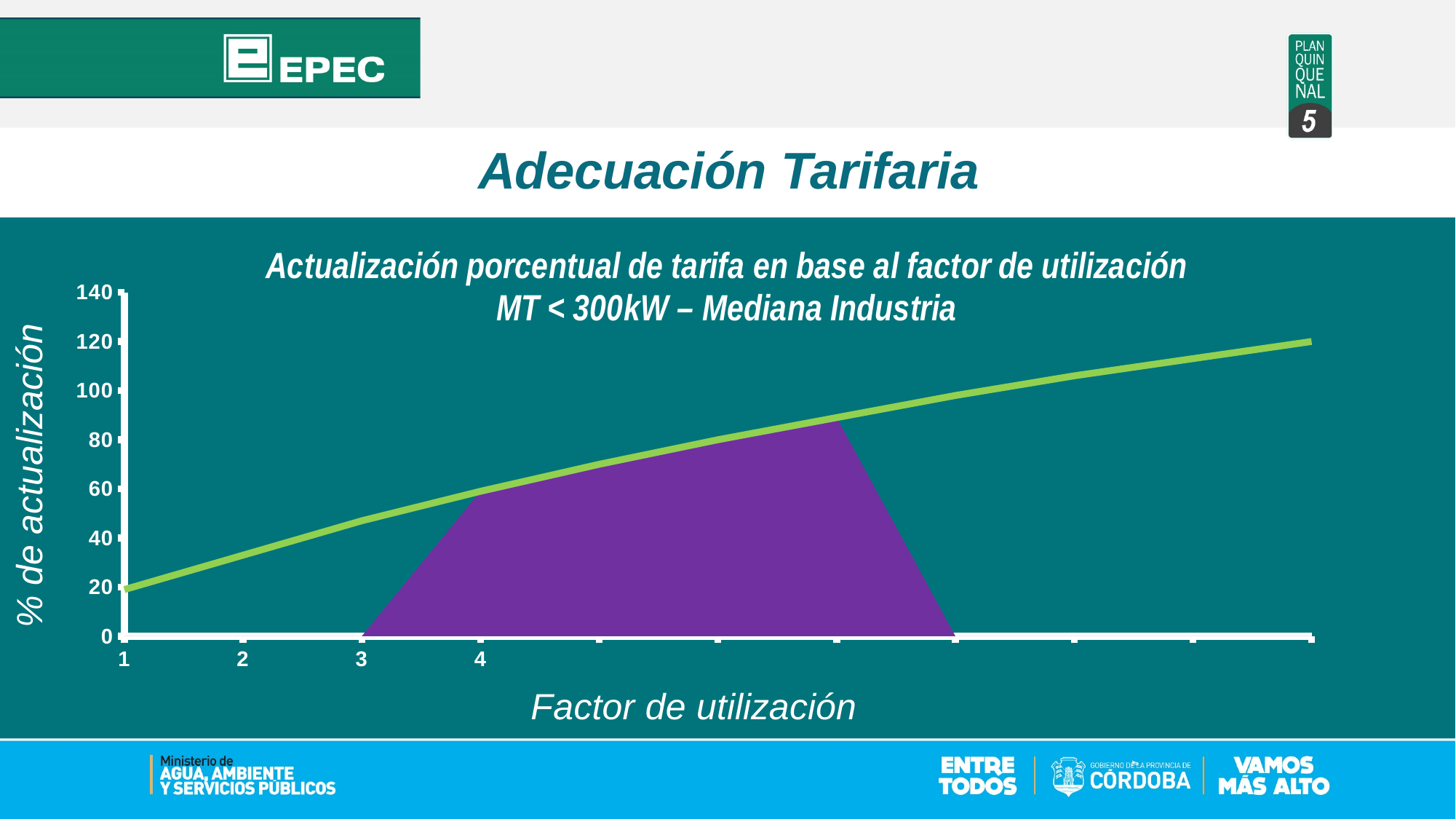
Is the value for factor de utilización 3 greater or less than 60? less Is the value for factor de utilización 4 greater or less than 40? greater Is the value for factor de utilización 1 greater or less than 40? less What is the label of the x axis of the chart? Factor de utilización What is the highest tick value shown on the y axis? 140 Which has the larger value, factor de utilización 2 or factor de utilización 4? 4 What kind of chart is shown on the slide? line chart Do the values of the line rise or fall as the factor de utilización increases? rise